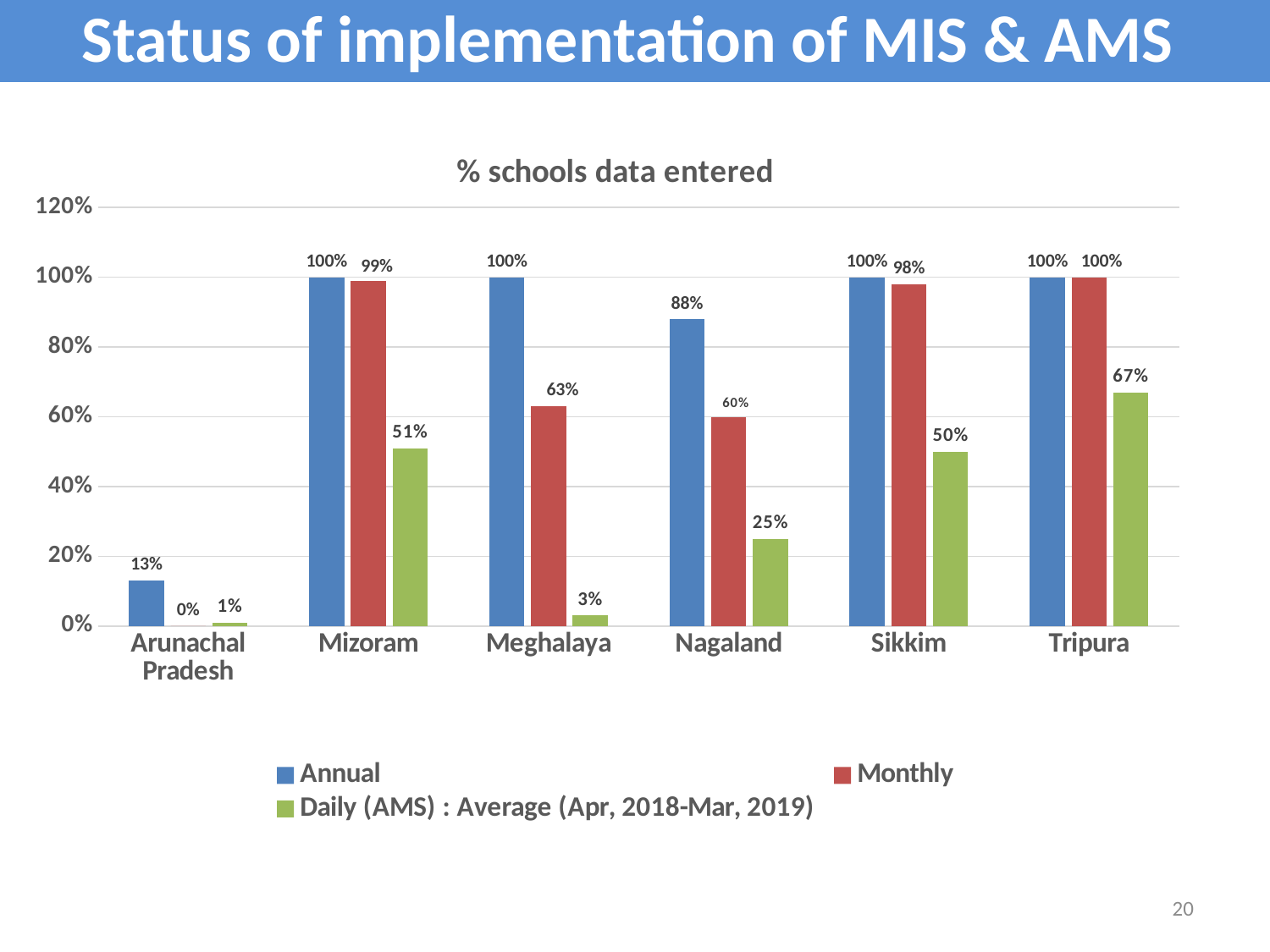
What kind of chart is shown on the slide? bar chart How many states are shown on the x axis? 6 Which is larger for Sikkim: the Monthly value or the Daily (AMS) value? Monthly What is the Monthly value for Meghalaya? 63% How many series does the legend list? 3 Which state has the highest Daily (AMS) value? Tripura What is the Daily (AMS) value for Tripura? 67% What is the difference between the Monthly and Daily (AMS) values for Mizoram? 48% What is the Annual value for Nagaland? 88% Is the Daily (AMS) value for Nagaland greater or less than 40%? less Which state has the lowest Daily (AMS) value? Arunachal Pradesh What is the title of the chart? % schools data entered